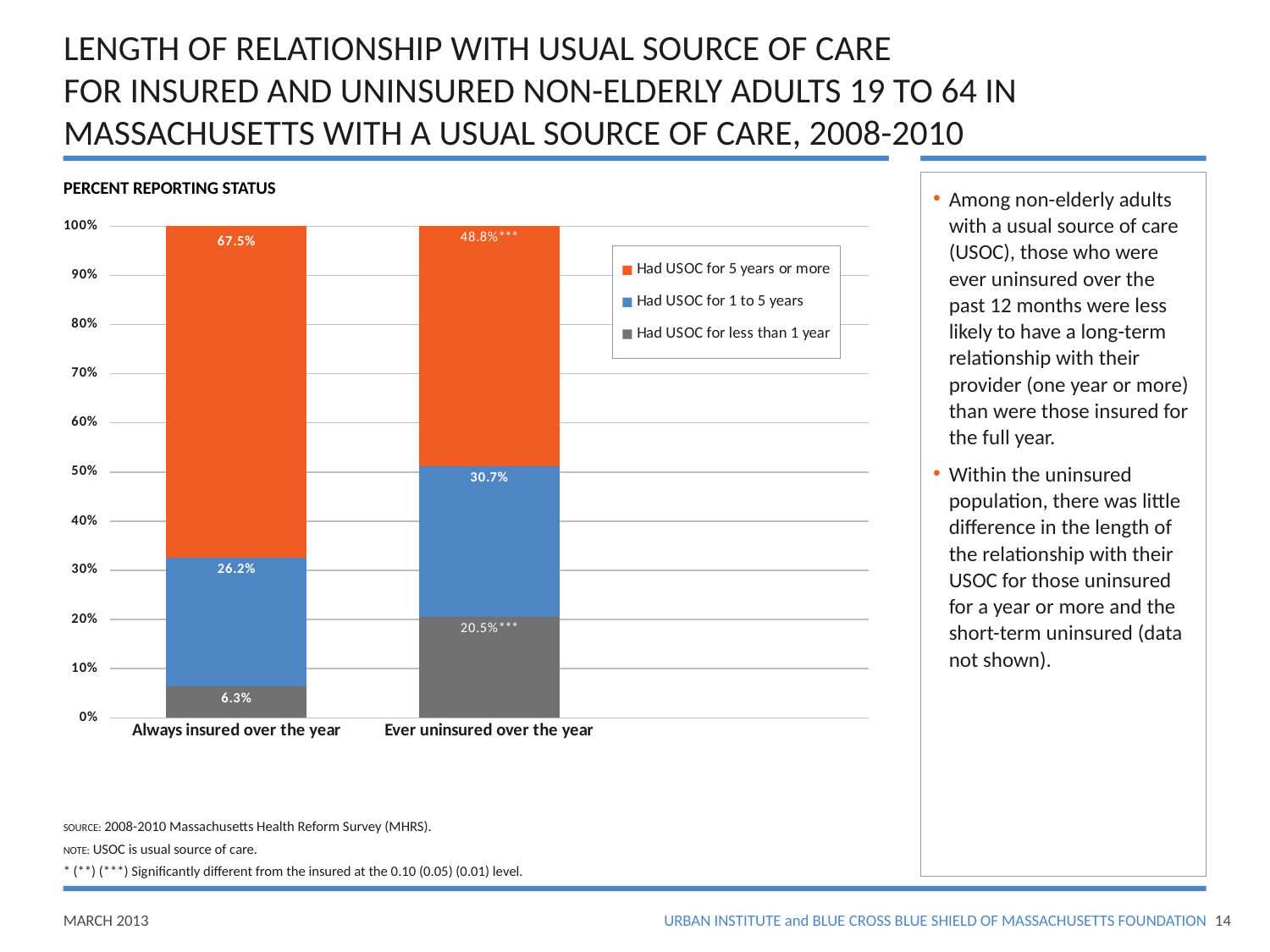
How many series does the legend list? 3 What percentage of adults ever uninsured over the year had a USOC for 1 to 5 years? 30.7% What percentage of adults always insured over the year had a USOC for less than 1 year? 6.3% What kind of chart is shown on the slide? Stacked bar chart Which group has the higher share with a USOC for 5 years or more, always insured or ever uninsured? Always insured over the year What percentage of adults ever uninsured over the year had a USOC for less than 1 year? 20.5% What percentage of adults always insured over the year had a USOC for 5 years or more? 67.5% How many categories are shown on the x axis? 2 What is the difference between the 'Had USOC for less than 1 year' shares for the ever uninsured and always insured groups? 14.2 percentage points Which colour represents 'Had USOC for 1 to 5 years' in the chart? Blue What is the difference between the 'Had USOC for 5 years or more' shares for the always insured and ever uninsured groups? 18.7 percentage points What is the label on the y axis of the chart? PERCENT REPORTING STATUS